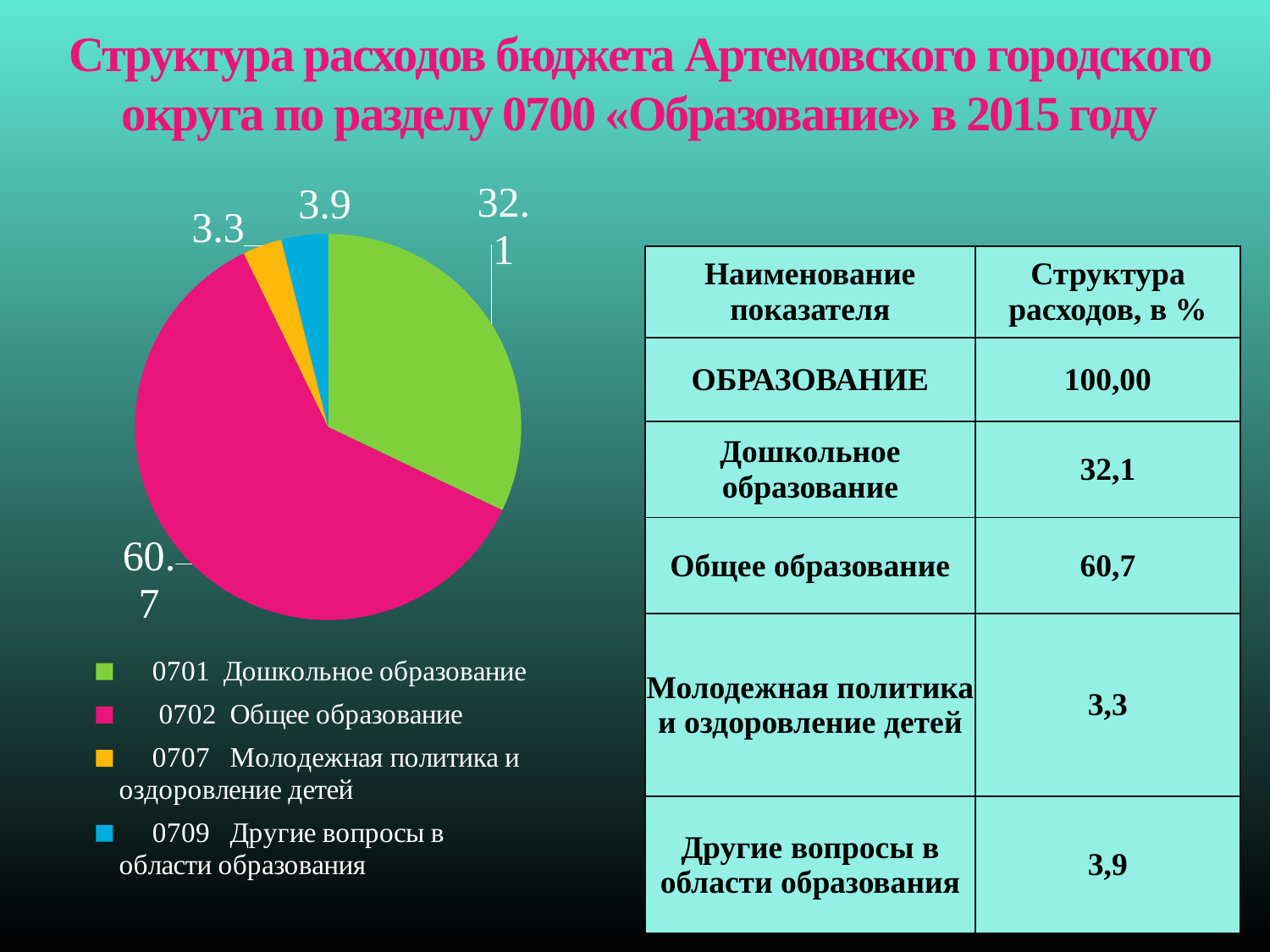
What is the value for 0707 Молодежная политика и оздоровление детей in the pie chart? 3.3 What is the difference between the values for 0702 Общее образование and 0701 Дошкольное образование? 28.6 Which is larger: the value for 0709 Другие вопросы в области образования or 0707 Молодежная политика и оздоровление детей? 0709 Другие вопросы в области образования What colour is the slice for 0701 Дошкольное образование? green Which category has the largest slice of the pie chart? 0702 Общее образование What is the value for 0709 Другие вопросы в области образования in the pie chart? 3.9 What type of chart is shown on the slide? pie chart What is the value for 0702 Общее образование in the pie chart? 60.7 What is the value for 0701 Дошкольное образование in the pie chart? 32.1 What colour is the slice for 0702 Общее образование? pink Which category has the smallest slice of the pie chart? 0707 Молодежная политика и оздоровление детей How many slices does the pie chart have? 4